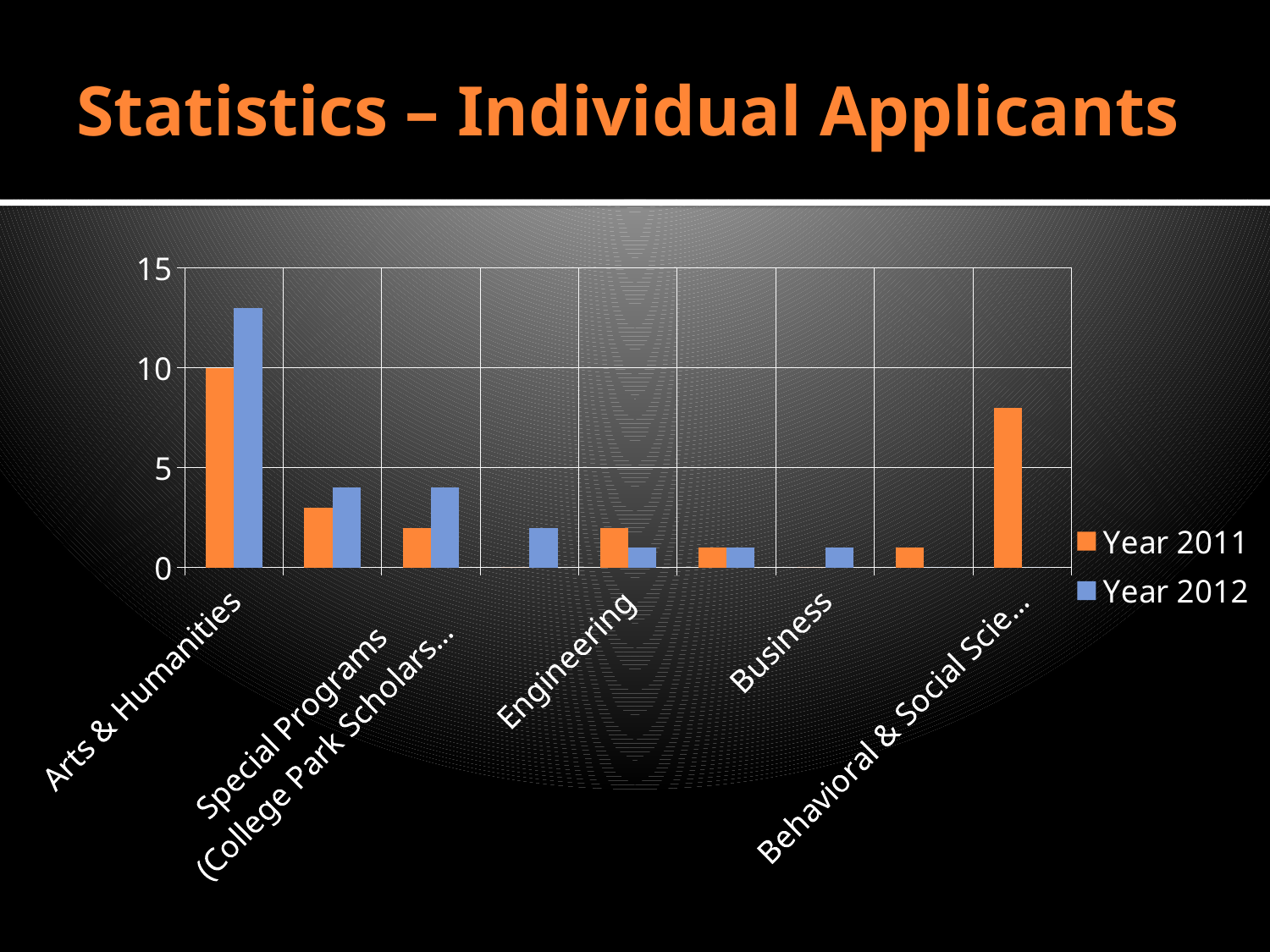
What kind of chart is shown on the slide? bar chart Is the Year 2012 value for Arts & Humanities greater or less than 10? greater Is the Year 2012 value for Special Programs (College Park Scholars) greater or less than 5? less What is the title of the slide containing the chart? Statistics – Individual Applicants How many series does the legend list? 2 Which category has the highest Year 2011 value? Arts & Humanities For Arts & Humanities, which is larger: the Year 2011 value or the Year 2012 value? Year 2012 Which category has the highest Year 2012 value? Arts & Humanities For Engineering, which is larger: the Year 2011 value or the Year 2012 value? Year 2011 Which series is shown in orange? Year 2011 Is the Year 2011 value for Behavioral & Social Sciences greater or less than 5? greater What is the Year 2011 value for Arts & Humanities? 10